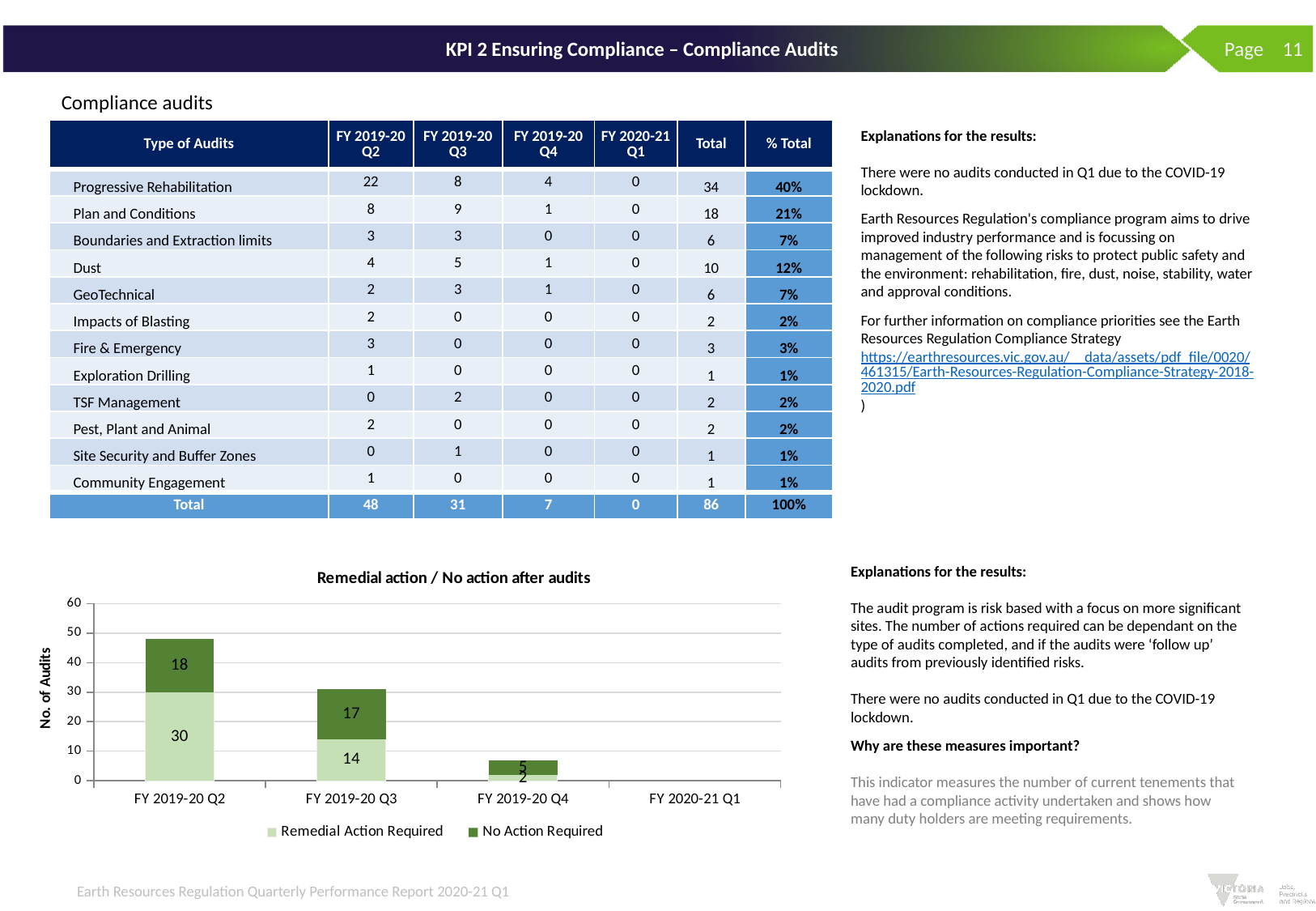
How many quarters are shown on the x axis of the "Remedial action / No action after audits" chart? 4 In the "Remedial action / No action after audits" chart, what is the total height of the stacked bar for FY 2019-20 Q2? 48 In the "Remedial action / No action after audits" chart, which quarter has the highest total number of audits? FY 2019-20 Q2 In the "Remedial action / No action after audits" chart, what is the No Action Required value for FY 2019-20 Q3? 17 How many series does the legend of the "Remedial action / No action after audits" chart list? 2 In the "Remedial action / No action after audits" chart, do the total audits rise or fall from FY 2019-20 Q2 to FY 2020-21 Q1? Fall In the "Remedial action / No action after audits" chart, what is the total height of the stacked bar for FY 2019-20 Q3? 31 In the "Remedial action / No action after audits" chart, what is the No Action Required value for FY 2019-20 Q4? 5 In the "Remedial action / No action after audits" chart, what is the difference between the Remedial Action Required values for FY 2019-20 Q2 and FY 2019-20 Q3? 16 In the "Remedial action / No action after audits" chart, what is the Remedial Action Required value for FY 2019-20 Q2? 30 In the "Remedial action / No action after audits" chart, is the Remedial Action Required value for FY 2019-20 Q3 larger or smaller than the No Action Required value for the same quarter? Smaller What type of chart is shown under the title "Remedial action / No action after audits"? Stacked bar chart